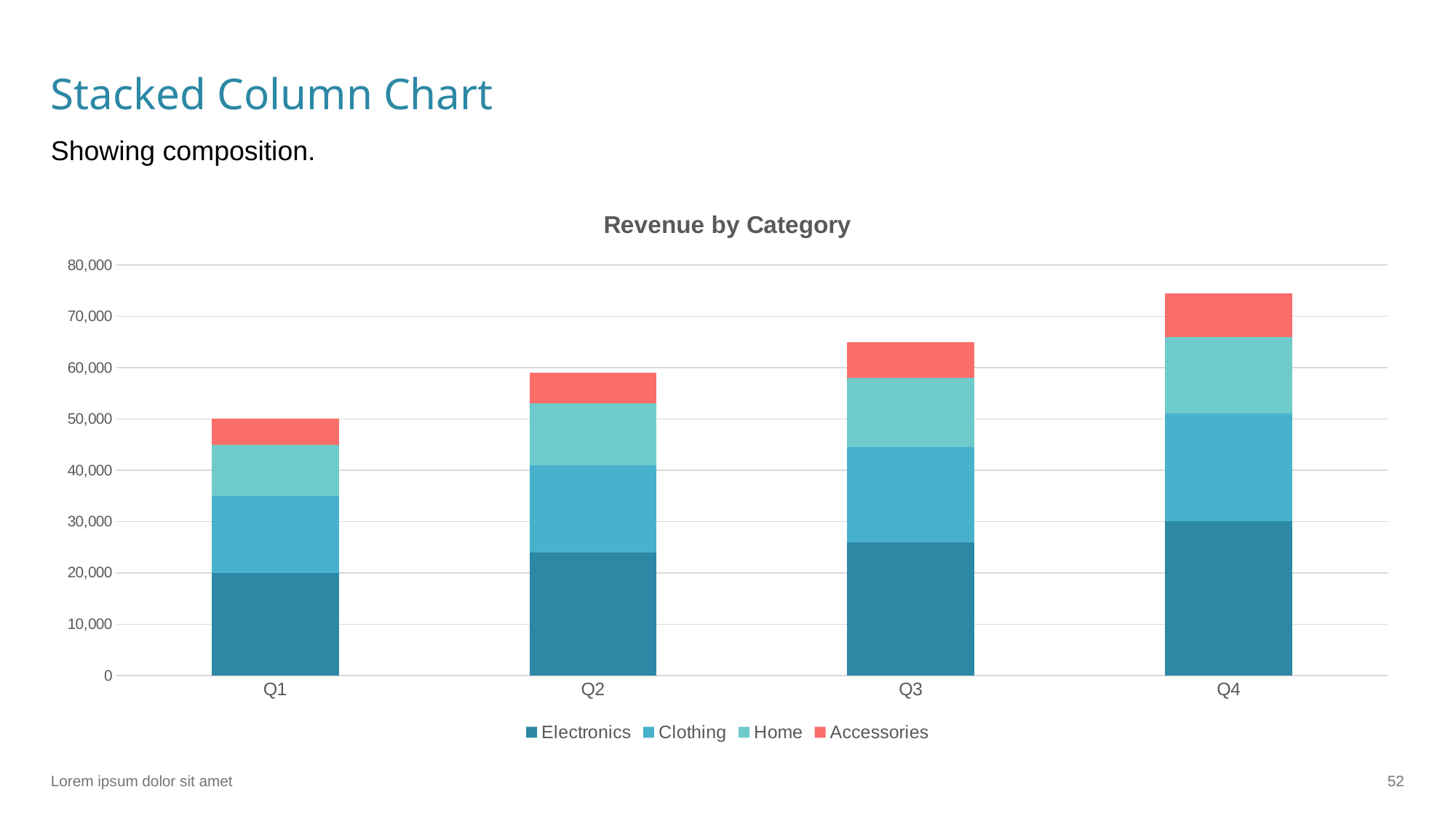
Is the total stacked value for Q4 greater or less than 70,000? greater What is the Electronics value for Q1? 20,000 Which quarter has the lowest total stacked bar? Q1 Do the total bar heights rise or fall from Q1 to Q4? Rise What is the Electronics value for Q4? 30,000 How many quarters are shown on the x axis? 4 How many series does the legend list? 4 What kind of chart is shown on the slide? Stacked bar chart Which series is shown in red in the legend? Accessories Which quarter has the highest total stacked bar? Q4 What is the title of the chart? Revenue by Category